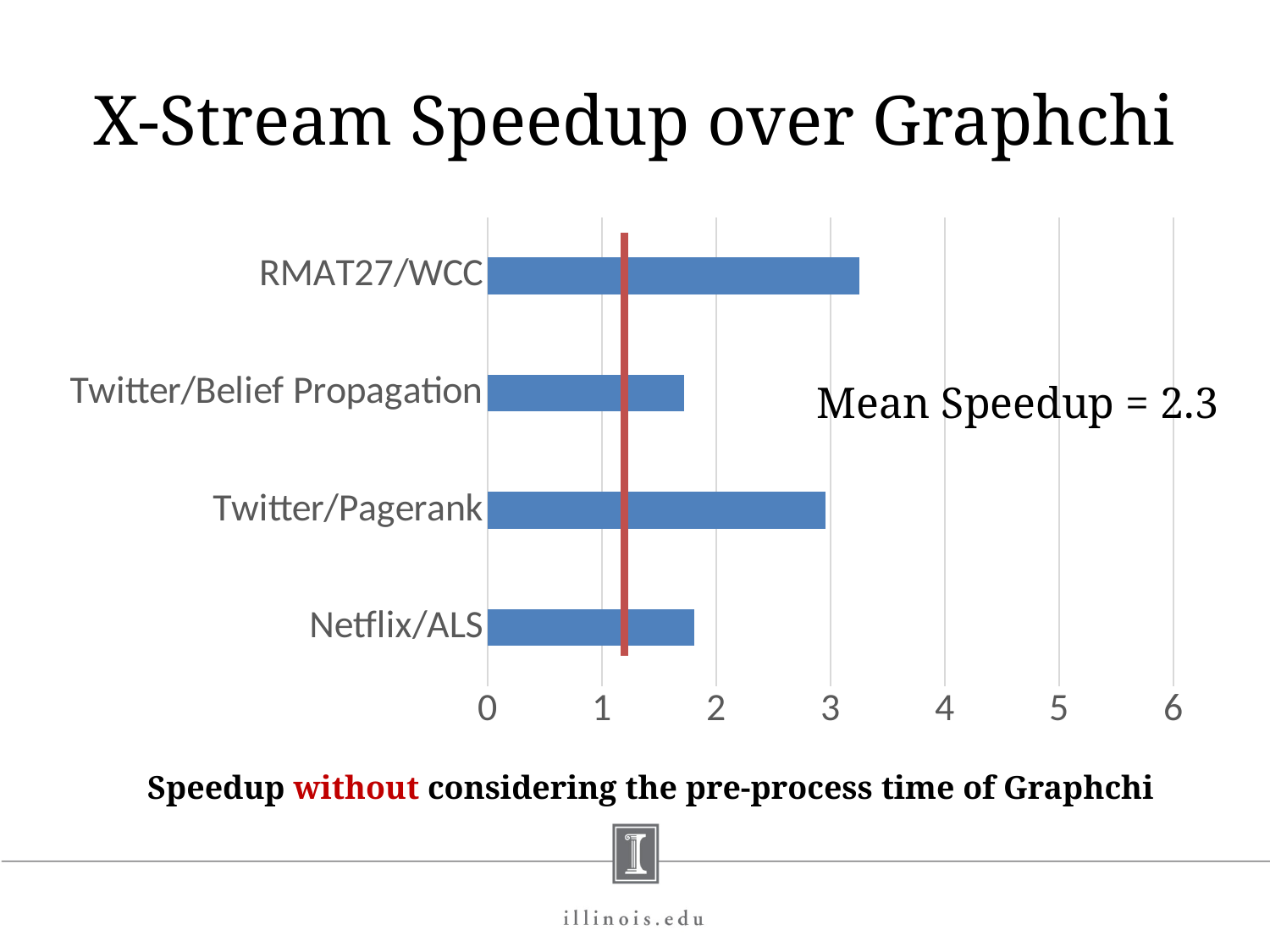
What mean speedup is stated on the slide? 2.3 What is the title of the chart? X-Stream Speedup over Graphchi Is the speedup for Netflix/ALS greater or less than 2? less Which has the larger speedup, RMAT27/WCC or Twitter/Belief Propagation? RMAT27/WCC Which has the larger speedup, Twitter/Pagerank or Netflix/ALS? Twitter/Pagerank What kind of chart is shown on the slide? bar chart Which category has the highest speedup? RMAT27/WCC Is the speedup for Twitter/Belief Propagation greater or less than 2? less Is the speedup for Twitter/Pagerank greater or less than 2? greater How many categories (bars) does the chart show? 4